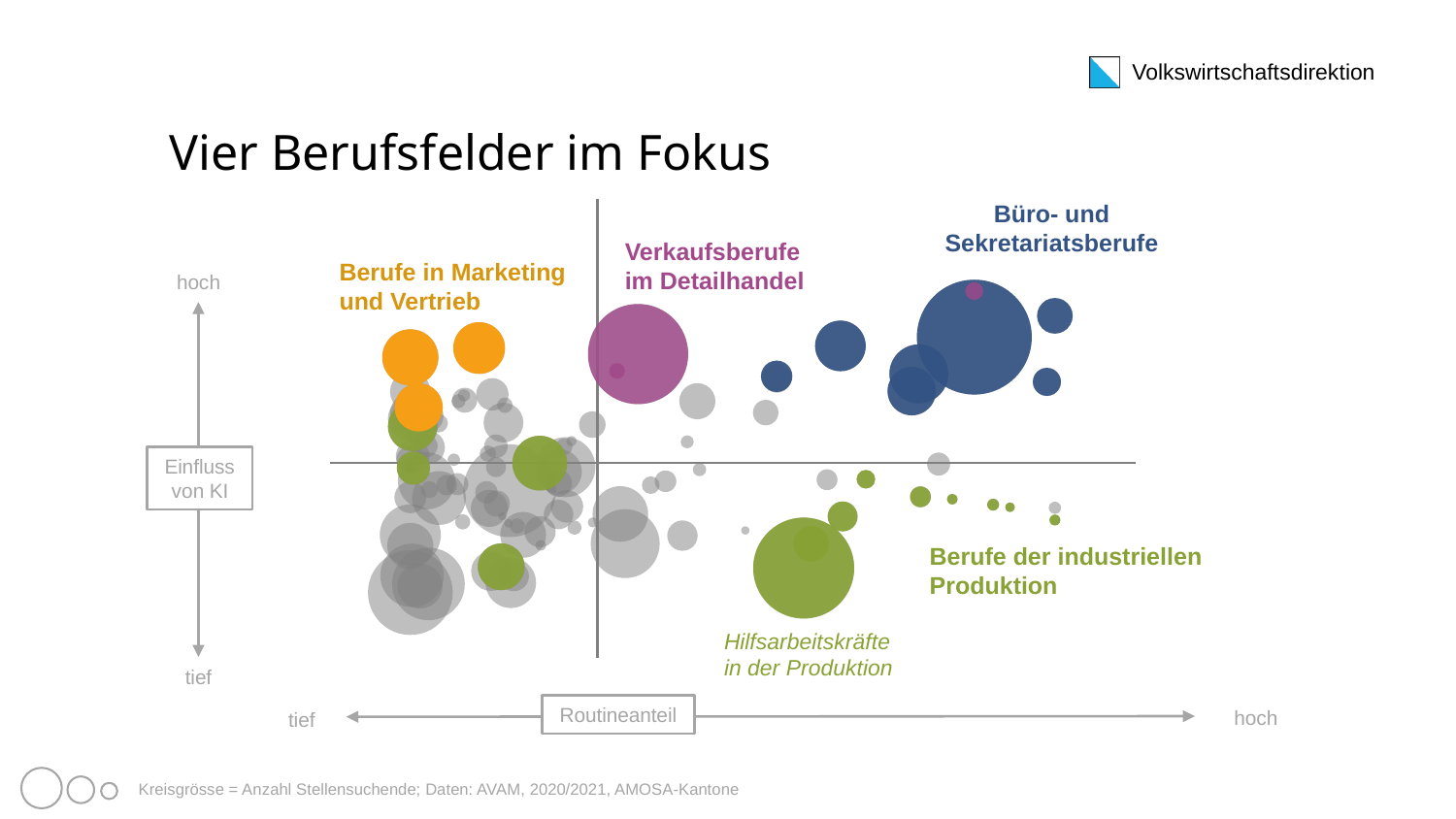
What does the vertical axis of the chart represent? Einfluss von KI Which occupational field is shown in green on the chart? Berufe der industriellen Produktion Which occupational field is shown in purple on the chart? Verkaufsberufe im Detailhandel Which occupational field is shown in orange on the chart? Berufe in Marketing und Vertrieb Which of the four highlighted occupational fields lies below the horizontal axis, i.e. has a low Einfluss von KI? Berufe der industriellen Produktion How many occupational fields are highlighted in colour and labelled in bold on the chart? 4 Which group has a higher Einfluss von KI: Büro- und Sekretariatsberufe or Berufe der industriellen Produktion? Büro- und Sekretariatsberufe Which group has a higher Routineanteil: Berufe in Marketing und Vertrieb or Büro- und Sekretariatsberufe? Büro- und Sekretariatsberufe What kind of chart is shown on the slide? Bubble chart What does the horizontal axis of the chart represent? Routineanteil What is the title of the slide? Vier Berufsfelder im Fokus Which occupational field is shown in dark blue on the chart? Büro- und Sekretariatsberufe